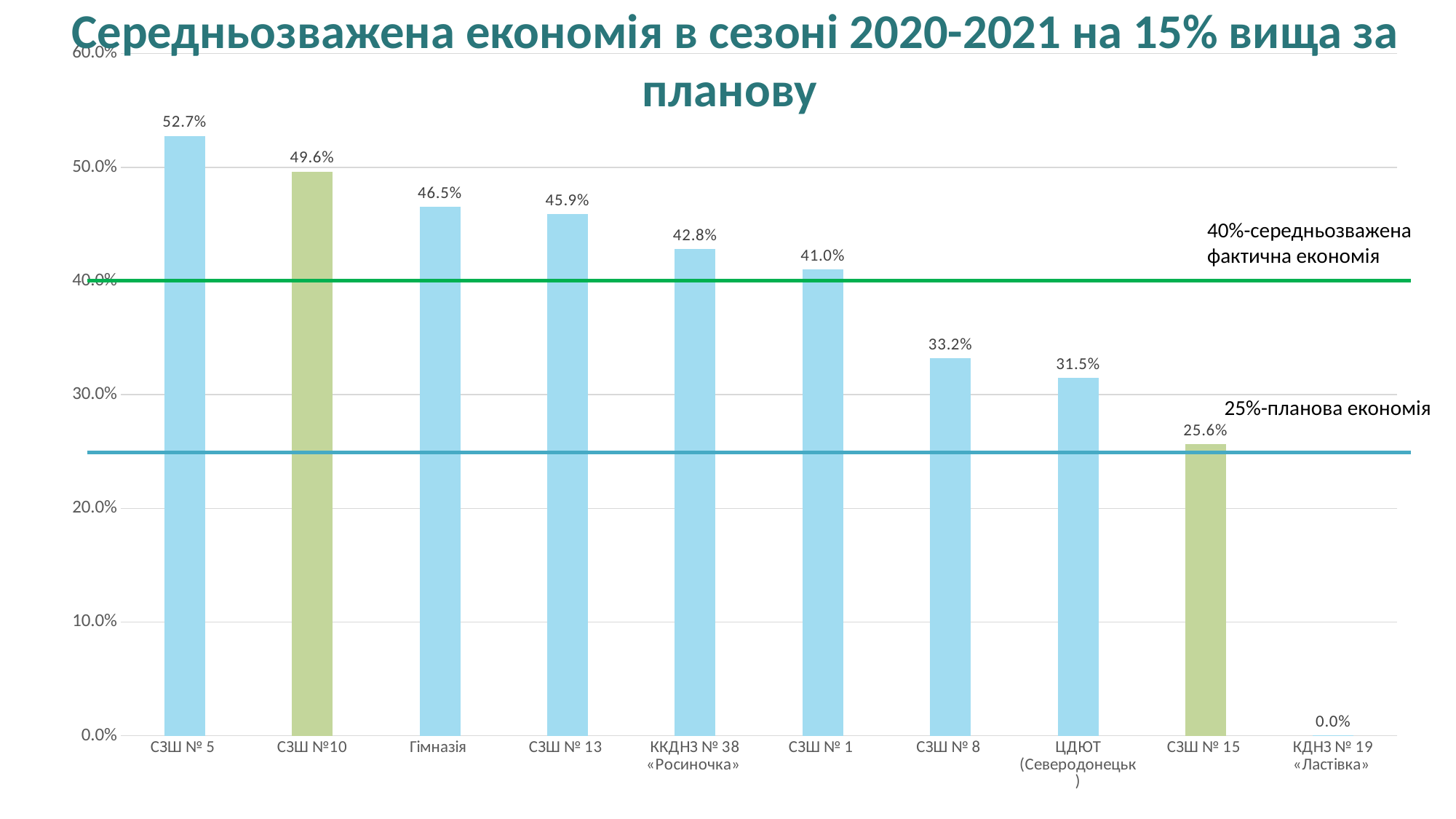
What is the value for КДНЗ № 38 «Росиночка»? 42.8% How many categories are shown on the x axis? 10 What kind of chart is shown on the slide? bar chart Which category has the lowest value? КДНЗ № 19 «Ластівка» Is the value for СЗШ № 8 greater or less than 40%? less Which is larger, the value for Гімназія or the value for СЗШ № 13? Гімназія Do the values rise or fall from left to right along the x axis? fall Which category has the highest value? СЗШ № 5 What is the value for СЗШ № 5? 52.7% What is the value for ЦДЮТ (Северодонецьк)? 31.5% What is the difference between the values for СЗШ № 5 and СЗШ №10? 3.1% What value does the green horizontal line labelled 'середньозважена фактична економія' mark? 40%